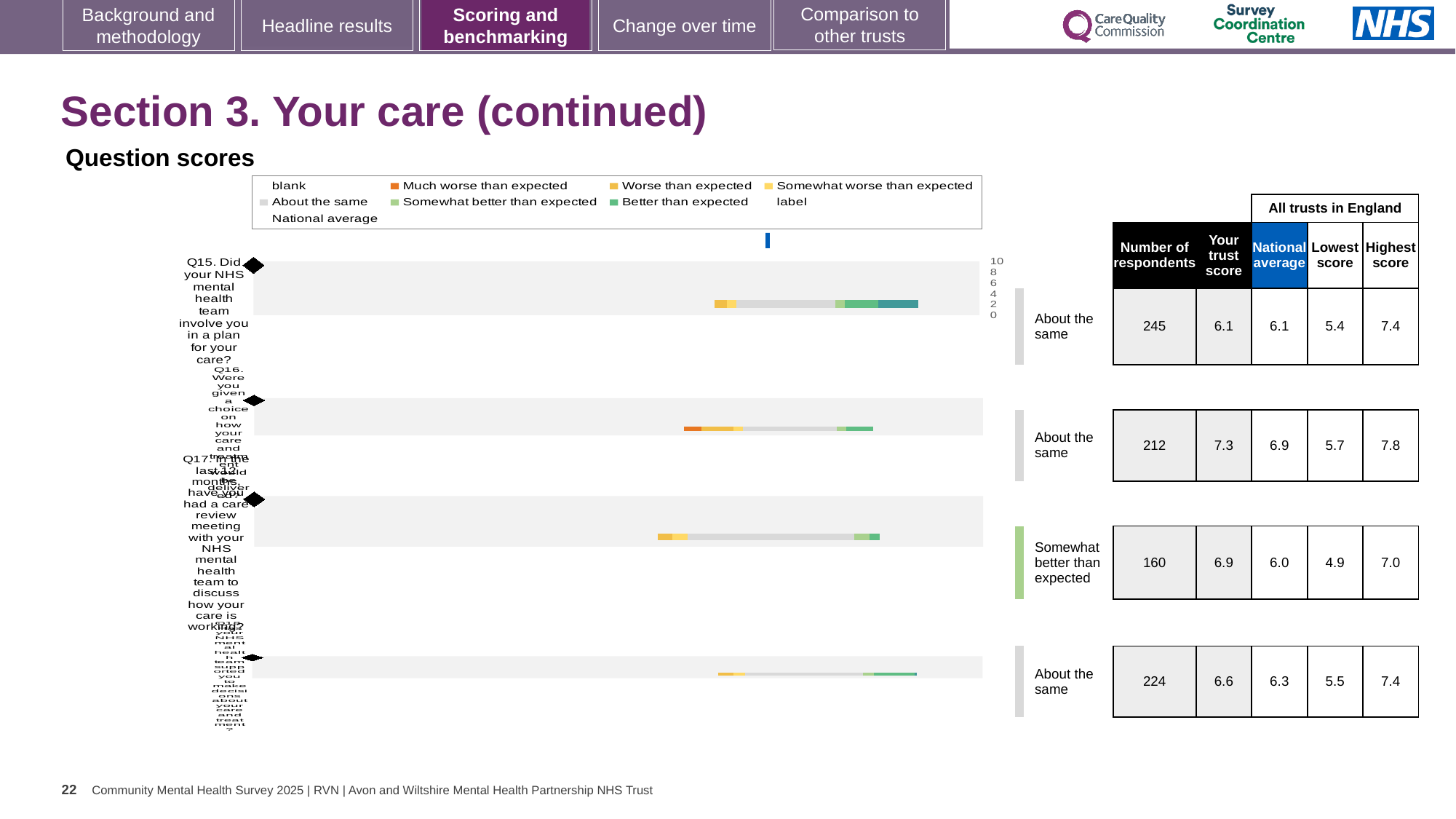
In the table, what is the highest score for Q16? 7.8 In the table, what is the national average for Q17? 6.0 In the table, how many respondents are listed for Q15? 245 Which question has the lowest number of respondents in the table? Q17 In the table, what is the trust score for Q16? 7.3 Which has the higher trust score, Q16 or Q17? Q16 What is the difference between the trust score and the national average for Q16? 0.4 What benchmark category is shown next to the Q17 bar? Somewhat better than expected In the table, what is the lowest score in the bottom (fourth) row? 5.5 What kind of chart is shown under 'Question scores'? bar chart Which question has the highest number of respondents in the table? Q15 How many question bars are plotted in the chart? 4